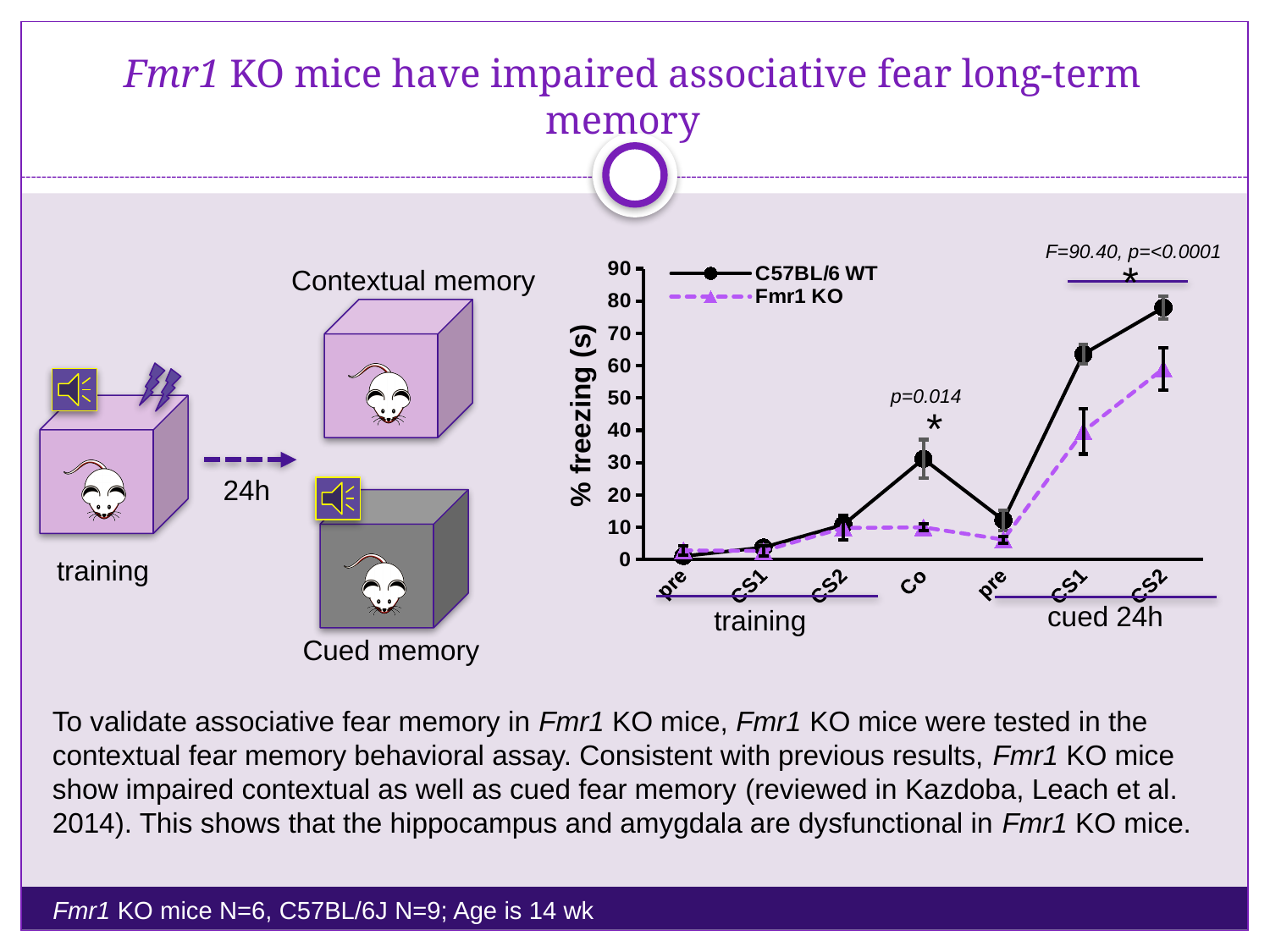
At CS2 in the cued 24h phase, which series has the higher % freezing? C57BL/6 WT Is the C57BL/6 WT value at CS2 in the cued 24h phase greater or less than 70? greater What kind of chart is shown on the slide? line chart Across the cued 24h phase (pre, CS1, CS2), do the C57BL/6 WT values rise or fall? rise At Co, which series has the higher % freezing, C57BL/6 WT or Fmr1 KO? C57BL/6 WT How many series does the chart's legend list? 2 Is the Fmr1 KO value at CS1 in the cued 24h phase greater or less than 50? less What is the label of the chart's y-axis? % freezing (s) How many x-axis points are plotted for each series in the chart? 7 Is the C57BL/6 WT value at Co greater or less than 20? greater At which x-axis point does the C57BL/6 WT series reach its highest value? CS2 (cued 24h)